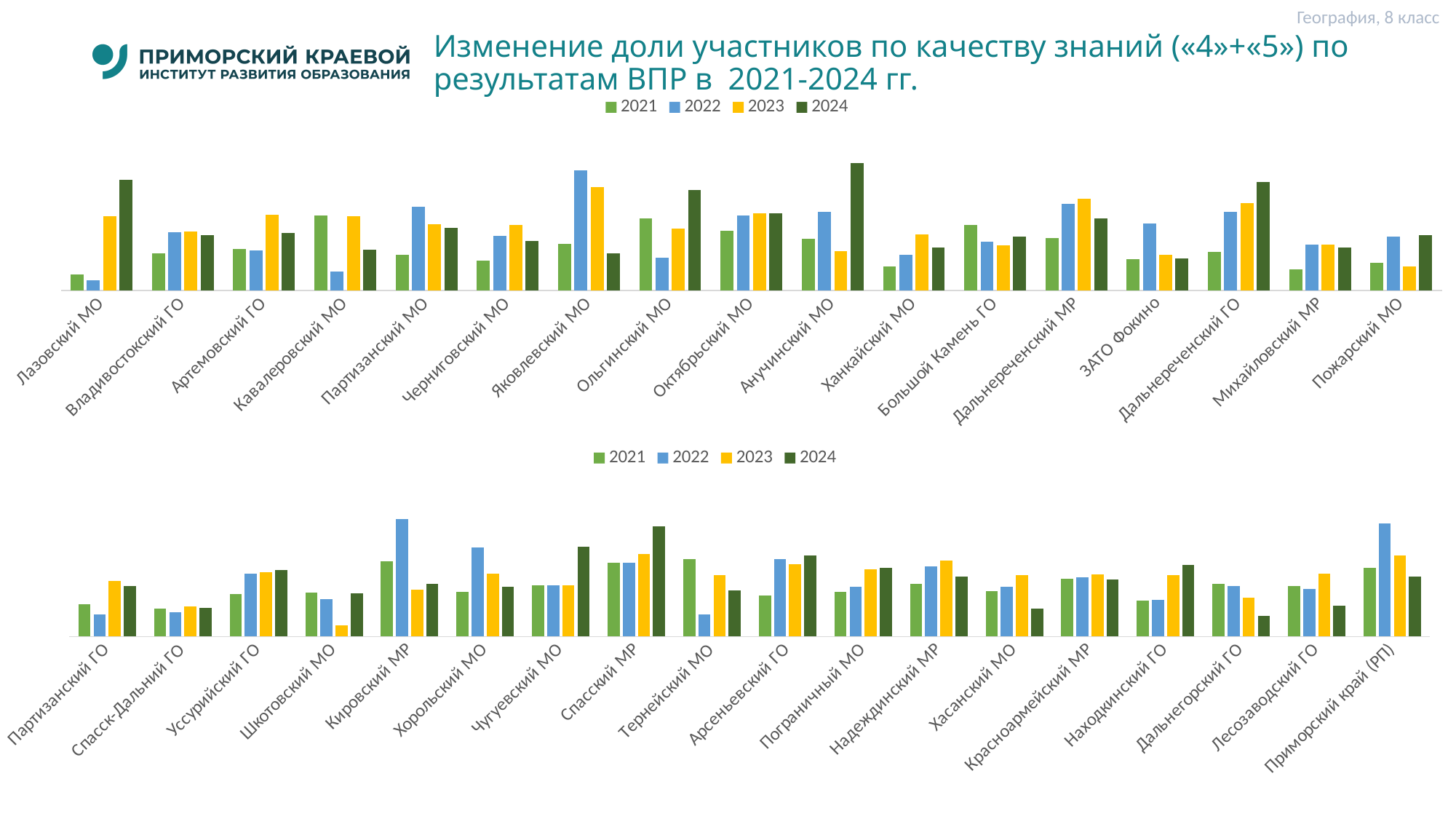
In the bottom chart, which year has the highest bar for Кировский МР? 2022 In the bottom chart, which year has the highest bar for Приморский край (РП)? 2022 In the top chart, which year has the highest bar for Лазовский МО? 2024 In the bottom chart, for Тернейский МО, is the 2021 bar or the 2022 bar larger? 2021 In the top chart, which year has the lowest bar for Кавалеровский МО? 2022 How many categories are shown on the x axis of the top chart? 17 In the bottom chart, which year has the lowest bar for Шкотовский МО? 2023 How many categories are shown on the x axis of the bottom chart? 18 How many series does the legend of the top chart list? 4 Which years are listed in the legend of the bottom chart? 2021, 2022, 2023, 2024 What kind of chart is the top chart on the slide? bar chart